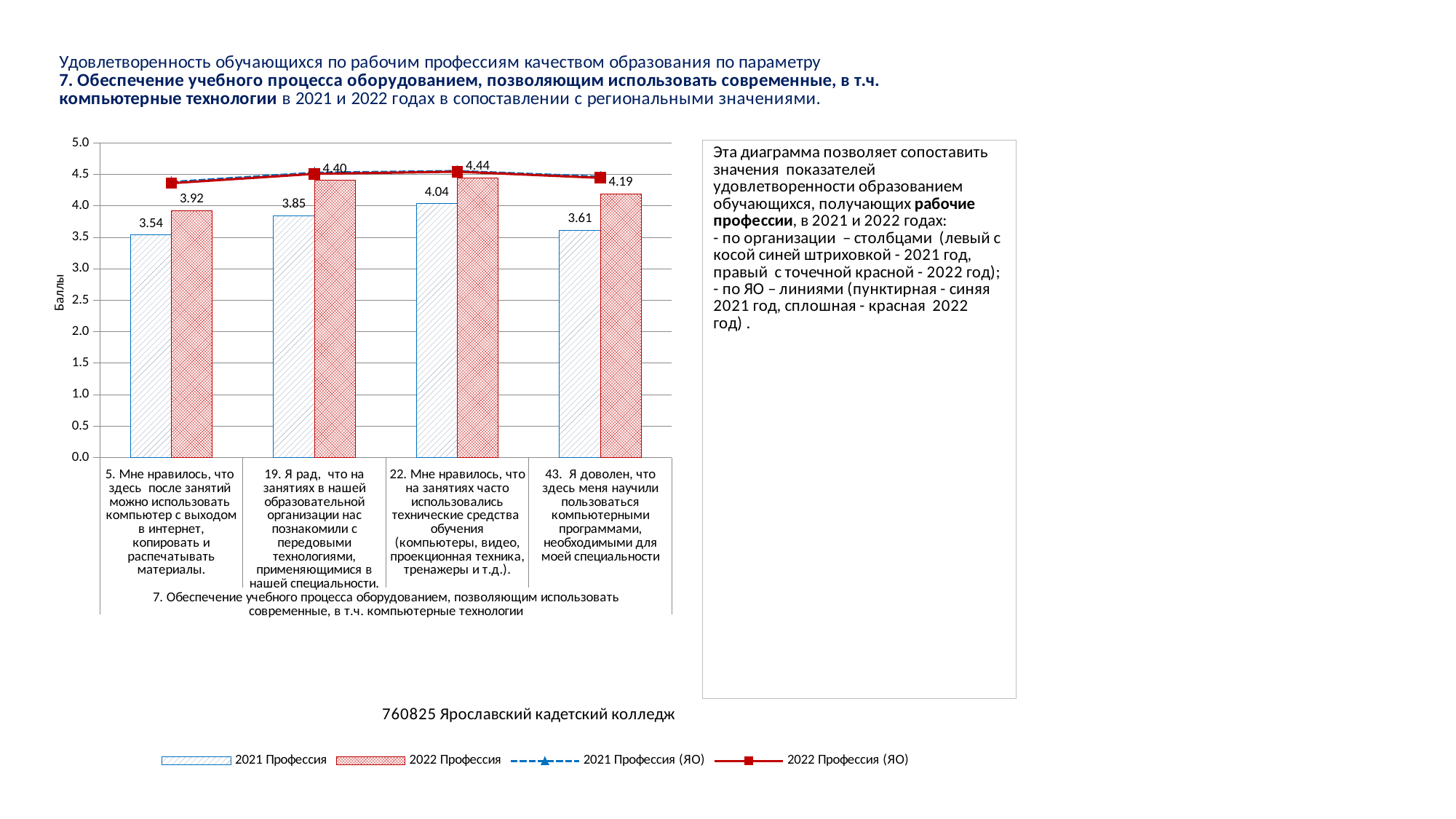
Which statement has the highest 2022 Профессия bar? 22. Мне нравилось, что на занятиях часто использовались технические средства обучения How many statements (categories) are shown on the x axis? 4 What is the value of the 2021 Профессия bar for statement 5 ("Мне нравилось, что здесь после занятий можно использовать компьютер...")? 3.54 What is the value of the 2022 Профессия bar for statement 43 ("Я доволен, что здесь меня научили пользоваться компьютерными программами...")? 4.19 How many series does the legend list? 4 Is the 2021 Профессия (ЯО) line value for statement 5 greater or less than 4.0? greater What is the label of the vertical axis? Баллы What kind of chart is shown on the slide? Combined bar and line chart For statement 22, which bar is larger: 2021 Профессия or 2022 Профессия? 2022 Профессия What is the difference between the 2022 and 2021 Профессия bars for statement 43? 0.58 What is the value of the 2022 Профессия bar for statement 19 ("Я рад, что на занятиях в нашей образовательной организации нас познакомили с передовыми технологиями...")? 4.40 Which statement has the lowest 2021 Профессия bar? 5. Мне нравилось, что здесь после занятий можно использовать компьютер с выходом в интернет